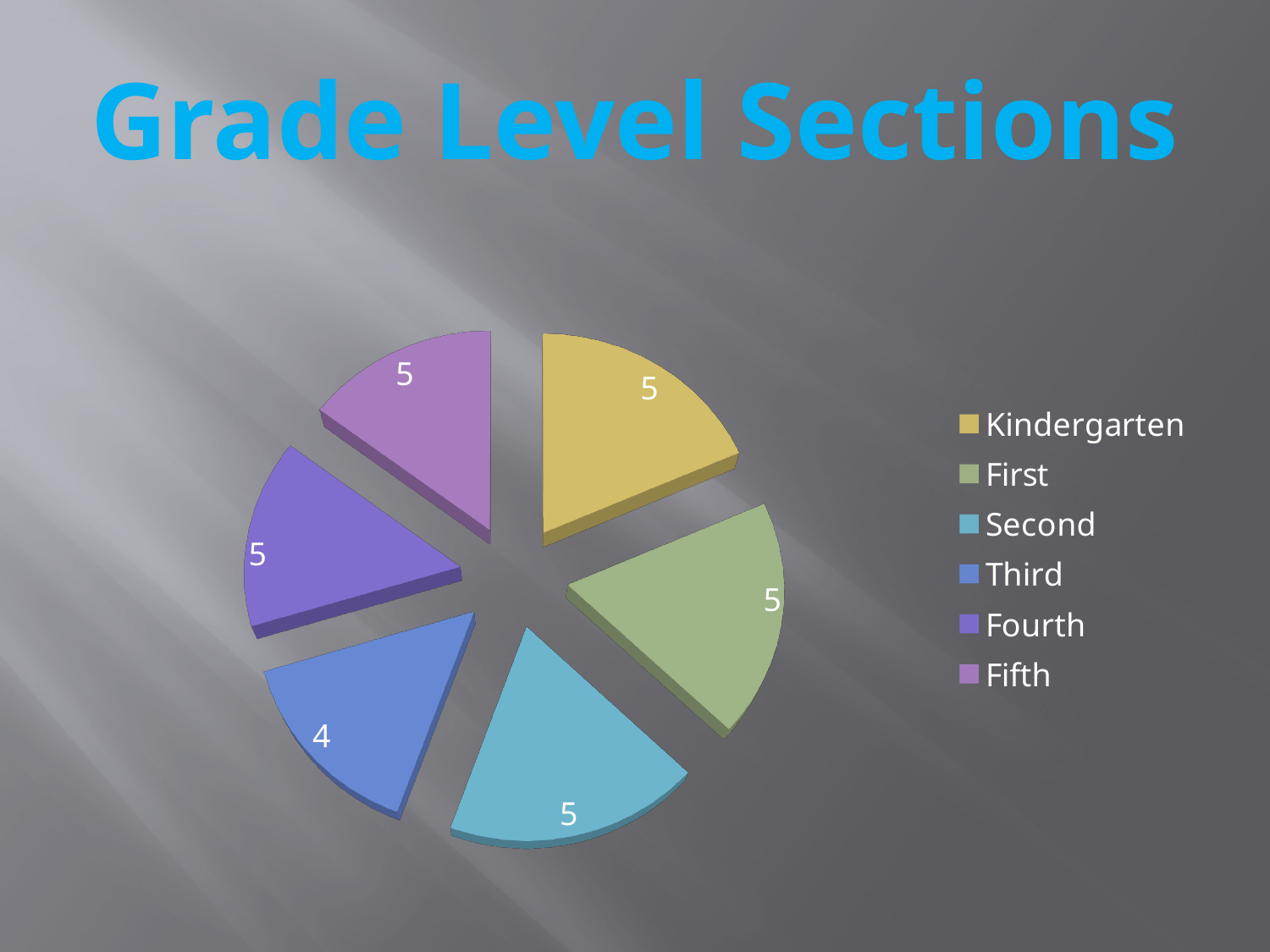
What is the value for Kindergarten? 5 What is the title of the slide? Grade Level Sections What is the difference between the value for First and the value for Third? 1 Which grade level has the smallest slice? Third Which is larger, the value for Kindergarten or the value for Third? Kindergarten How many slices does the pie chart have? 6 What is the total of all the slice values in the pie chart? 29 What is the value for Third? 4 What is the value for Fifth? 5 Which legend entry is shown in gold/yellow? Kindergarten What is the value for Second? 5 What type of chart is shown on the slide? pie chart